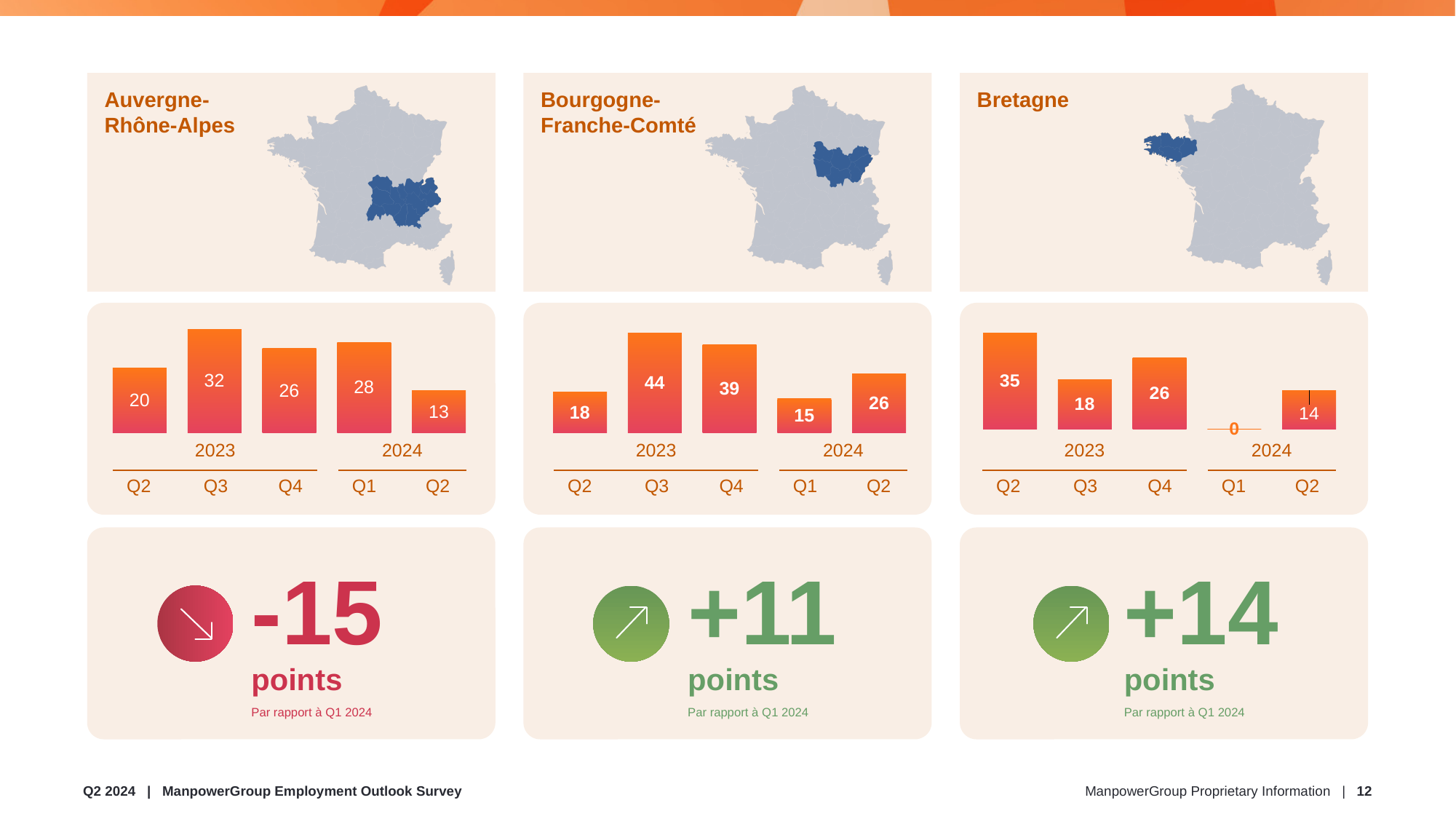
What kind of chart is used for the Auvergne-Rhône-Alpes panel? Bar chart In the Bretagne chart, what is the difference between Q2 2023 and Q3 2023? 17 In the Auvergne-Rhône-Alpes chart, what is the value for Q3 2023? 32 In the Bretagne chart, what is the value for Q1 2024? 0 In the Bourgogne-Franche-Comté chart, which quarter has the highest value? Q3 2023 In the Auvergne-Rhône-Alpes chart, which quarter has the lowest value? Q2 2024 In the Bourgogne-Franche-Comté chart, do the values rise or fall from Q3 2023 to Q1 2024? Fall In the Auvergne-Rhône-Alpes chart, what is the difference between Q1 2024 and Q2 2024? 15 In the Bourgogne-Franche-Comté chart, which is larger, Q2 2023 or Q2 2024? Q2 2024 How many quarters are plotted in the Bretagne chart? 5 In the Bourgogne-Franche-Comté chart, what is the value for Q4 2023? 39 In the Bretagne chart, which quarter has the highest value? Q2 2023